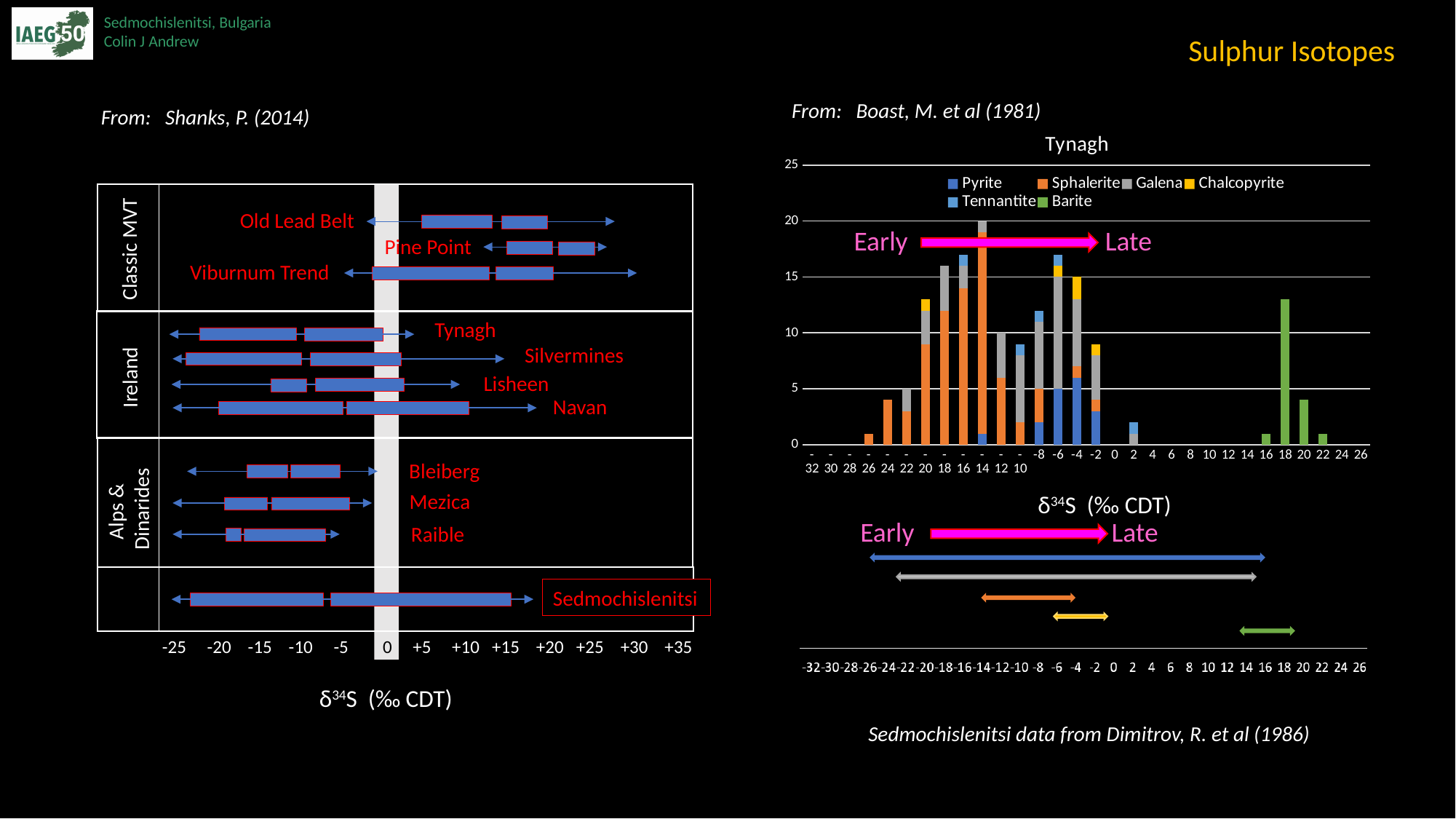
How many series does the legend of the Tynagh chart list? 6 In the Tynagh chart, is the total height of the bar at -14 greater or less than 15? greater In the Tynagh chart, which mineral is shown in green in the legend? Barite In the left chart (from Shanks, P. 2014), is the boxed range for Bleiberg greater or less than 0? less In the left chart (from Shanks, P. 2014), how many deposits are listed in the Classic MVT group? 3 In the Tynagh chart, is the height of the green Barite bar at 18 greater or less than 10? greater In the left chart (from Shanks, P. 2014), how many deposits are listed in the Ireland group? 4 In the Tynagh chart, which bar is taller: the one at -14 or the one at 18? -14 In the Tynagh chart, which mineral is shown in orange in the legend? Sphalerite In the Tynagh chart, at which δ34S value is the tallest stacked bar? -14 What kind of chart is the Tynagh chart on the right side of the slide? bar chart